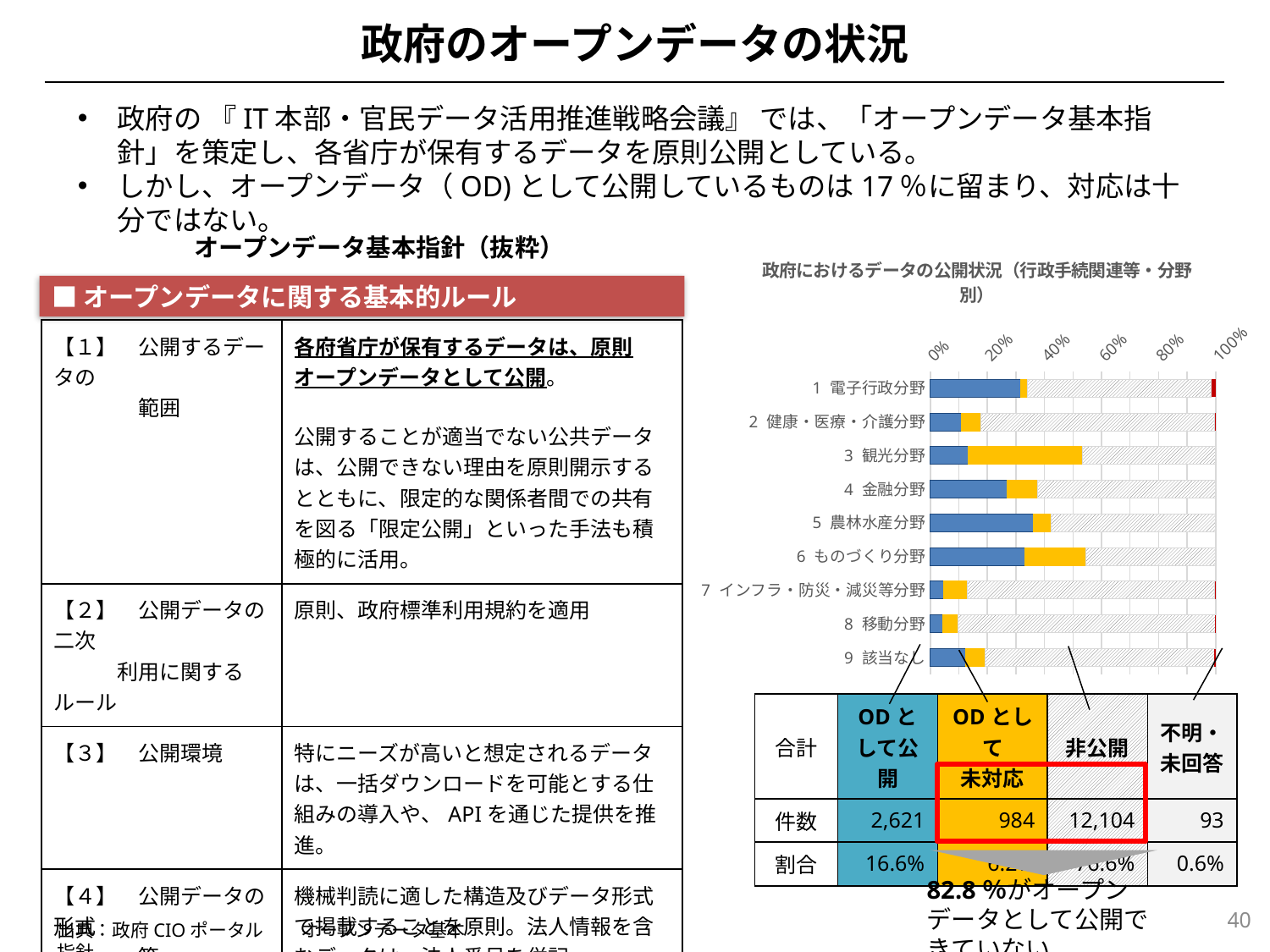
Which has the larger blue (ODとして公開) segment in the chart: 1 電子行政分野 or 2 健康・医療・介護分野? 1 電子行政分野 In the chart, is the blue (ODとして公開) segment for 2 健康・医療・介護分野 greater or less than 20%? less In the chart, does the combined blue and yellow portion for 3 観光分野 extend beyond 40% or stop short of it? greater What is the title of the chart on the right side of the slide? 政府におけるデータの公開状況（行政手続関連等・分野別） Which category has the widest yellow (ODとして未対応) segment in the chart? 3 観光分野 In the chart, is the blue (ODとして公開) segment for 8 移動分野 greater or less than 20%? less Which has the larger yellow (ODとして未対応) segment in the chart: 3 観光分野 or 4 金融分野? 3 観光分野 What kind of chart is shown on the right side of the slide under the title 政府におけるデータの公開状況? bar chart What is the highest percentage tick shown on the horizontal axis of the chart? 100% How many categories (分野) are listed on the vertical axis of the chart? 9